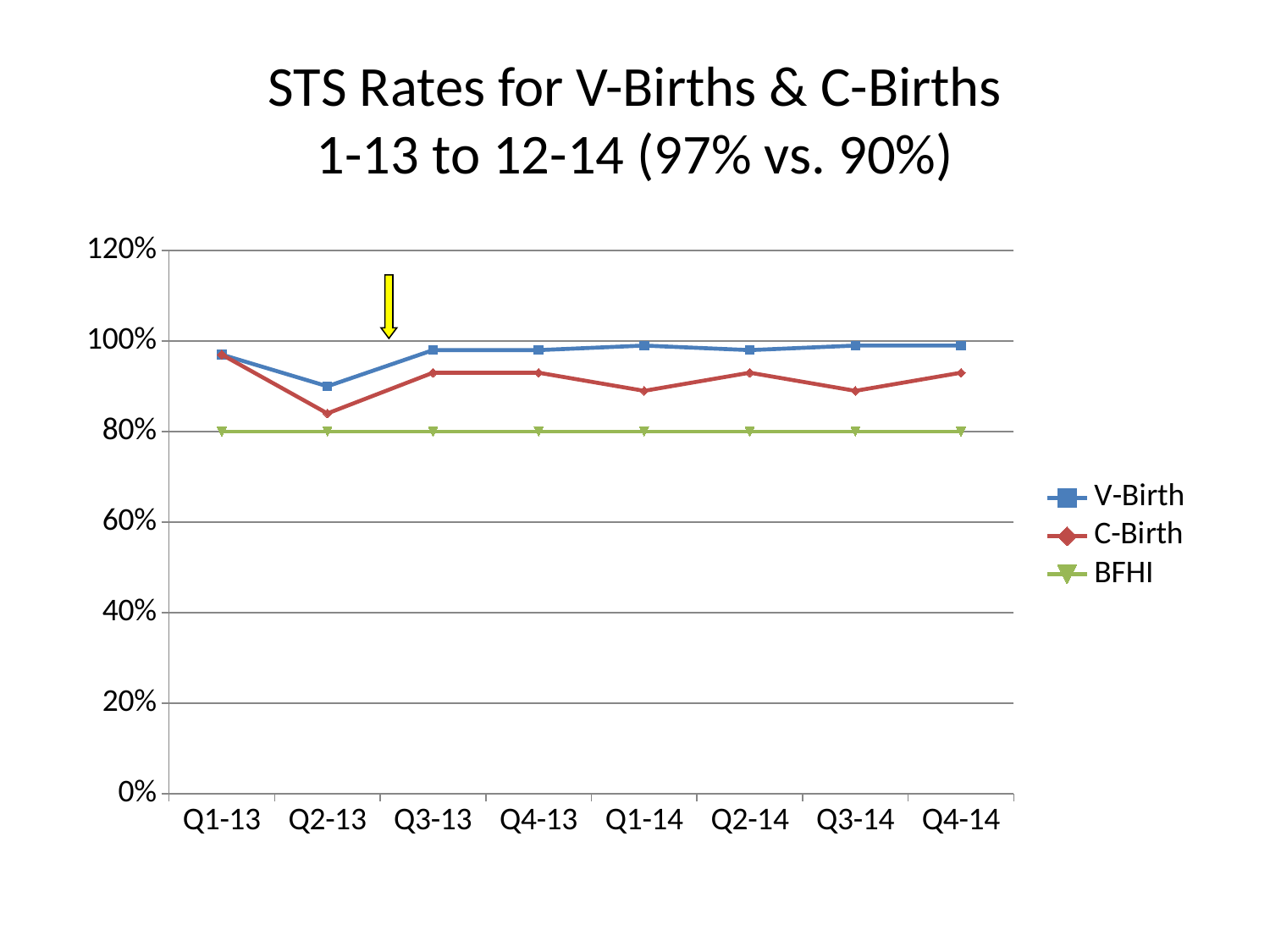
What kind of chart is shown on the slide? line chart Is the value for C-Birth at Q1-14 greater or less than 100%? less What is the value of the BFHI series at Q4-14? 80% Is the value for C-Birth at Q2-13 greater or less than 80%? greater At Q2-13, which series has the higher value, V-Birth or C-Birth? V-Birth In which quarter is the V-Birth series at its lowest? Q2-13 In which quarter is the C-Birth series at its lowest? Q2-13 How many quarters are plotted along the x axis? 8 Does the C-Birth series rise or fall from Q1-13 to Q2-13? fall Is the value for V-Birth at Q3-13 greater or less than 100%? less How many series does the legend list? 3 Which series is drawn in green? BFHI